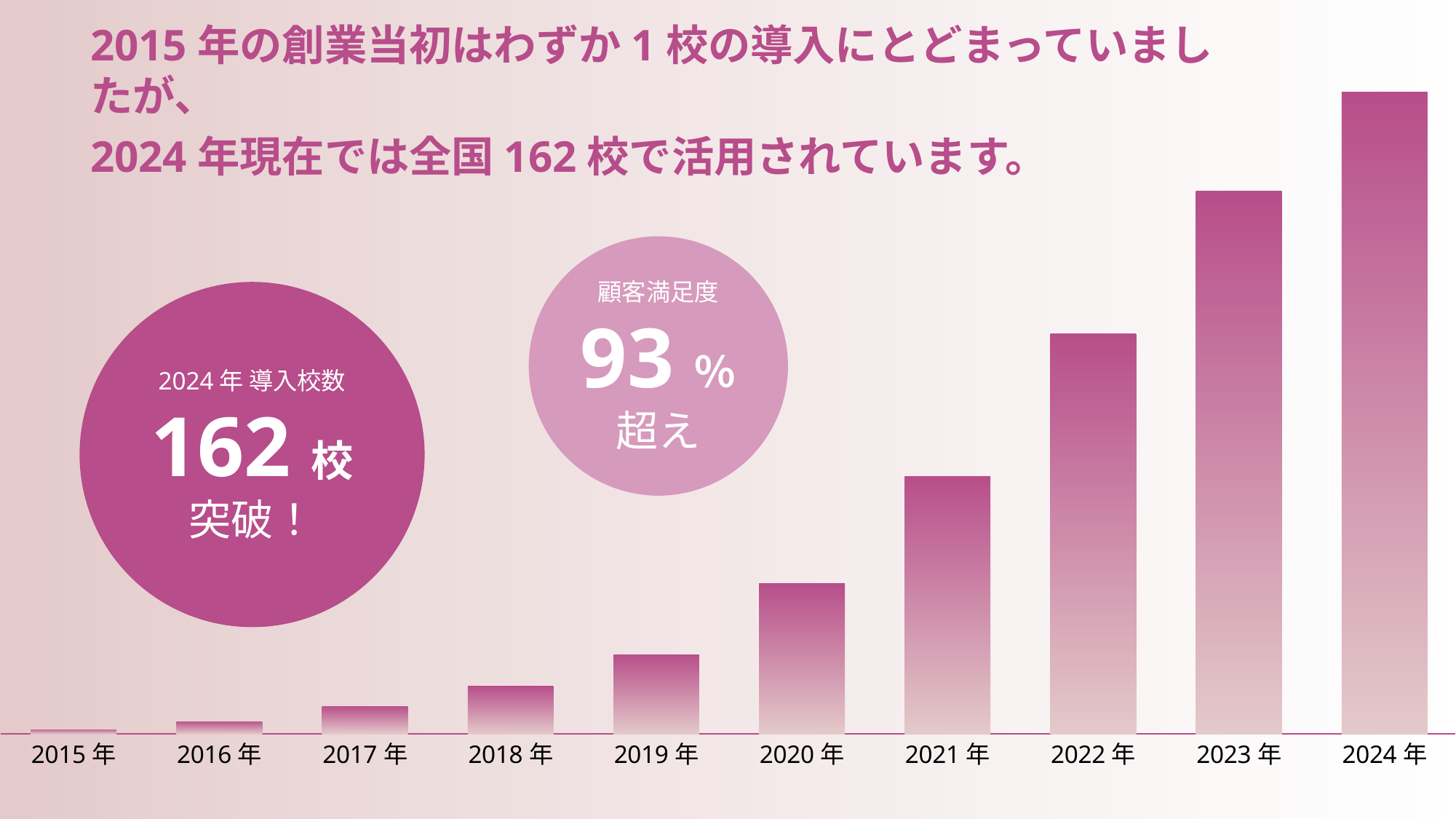
Which year has the tallest bar in the chart? 2024年 Which bar is taller, 2023年 or 2020年? 2023年 Which bar is taller, 2019年 or 2018年? 2019年 According to the slide, how many schools had adopted the product in 2015年? 1校 Which bar is taller, 2021年 or 2022年? 2022年 According to the slide, how many schools had adopted the product in 2024年? 162校 Do the bar values rise or fall from 2015年 to 2024年? rise What is the first year shown on the x axis of the chart? 2015年 How many years are shown on the x axis of the chart? 10 Which year has the shortest bar in the chart? 2015年 What kind of chart is shown on the slide? bar chart What customer satisfaction figure (顧客満足度) is shown in the circle on the slide? 93%超え